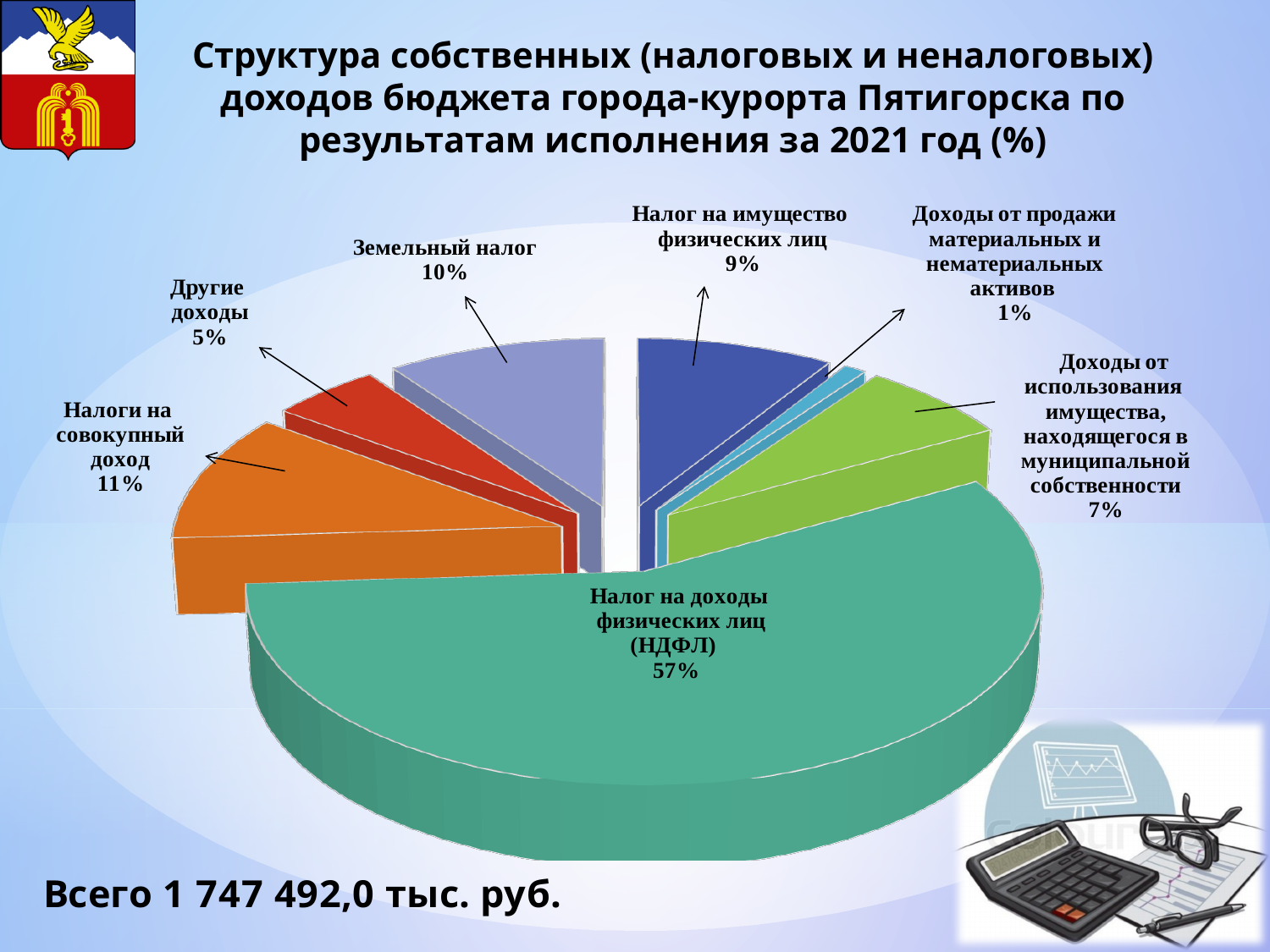
What is the value shown for "Доходы от продажи материальных и нематериальных активов"? 1% What is the value shown for "Земельный налог"? 10% How many slices does the pie chart have? 7 What share of the pie does "Налог на доходы физических лиц (НДФЛ)" have? 57% What kind of chart is shown on the slide? Pie chart What year does the chart title say the data refers to? 2021 Which category has the largest share of the pie? Налог на доходы физических лиц (НДФЛ) Which category has the smallest share of the pie? Доходы от продажи материальных и нематериальных активов What is the value shown for "Налоги на совокупный доход"? 11% What is the difference between the shares of "Налоги на совокупный доход" and "Другие доходы"? 6% Which is larger: the share of "Налог на имущество физических лиц" or the share of "Доходы от использования имущества, находящегося в муниципальной собственности"? Налог на имущество физических лиц What total amount is stated at the bottom of the slide? 1 747 492,0 тыс. руб.